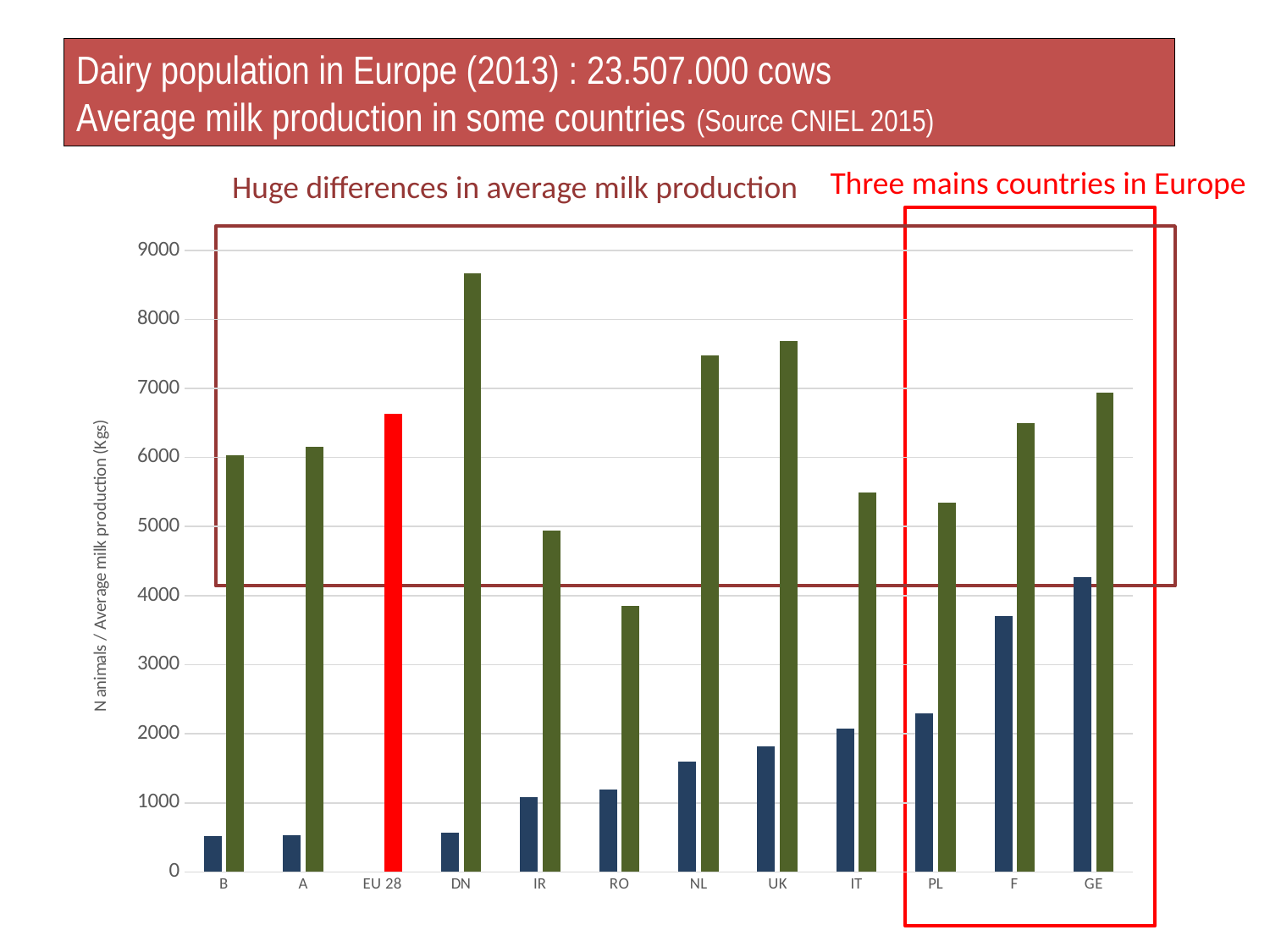
Which has the taller green bar, F or GE? GE Is the blue bar for B greater or less than 1000? less Which category has the tallest green bar (highest average milk production)? DN What kind of chart is shown on the slide? bar chart Is the blue bar for GE greater or less than 4000? greater What is the label of the vertical axis? N animals / Average milk production (Kgs) Which category is shown with a red bar? EU 28 Is the green bar for DN greater or less than 8000? greater Which category has the shortest green bar (lowest average milk production)? RO How many countries/categories are shown on the x axis of the chart? 12 Which category has the tallest blue bar? GE